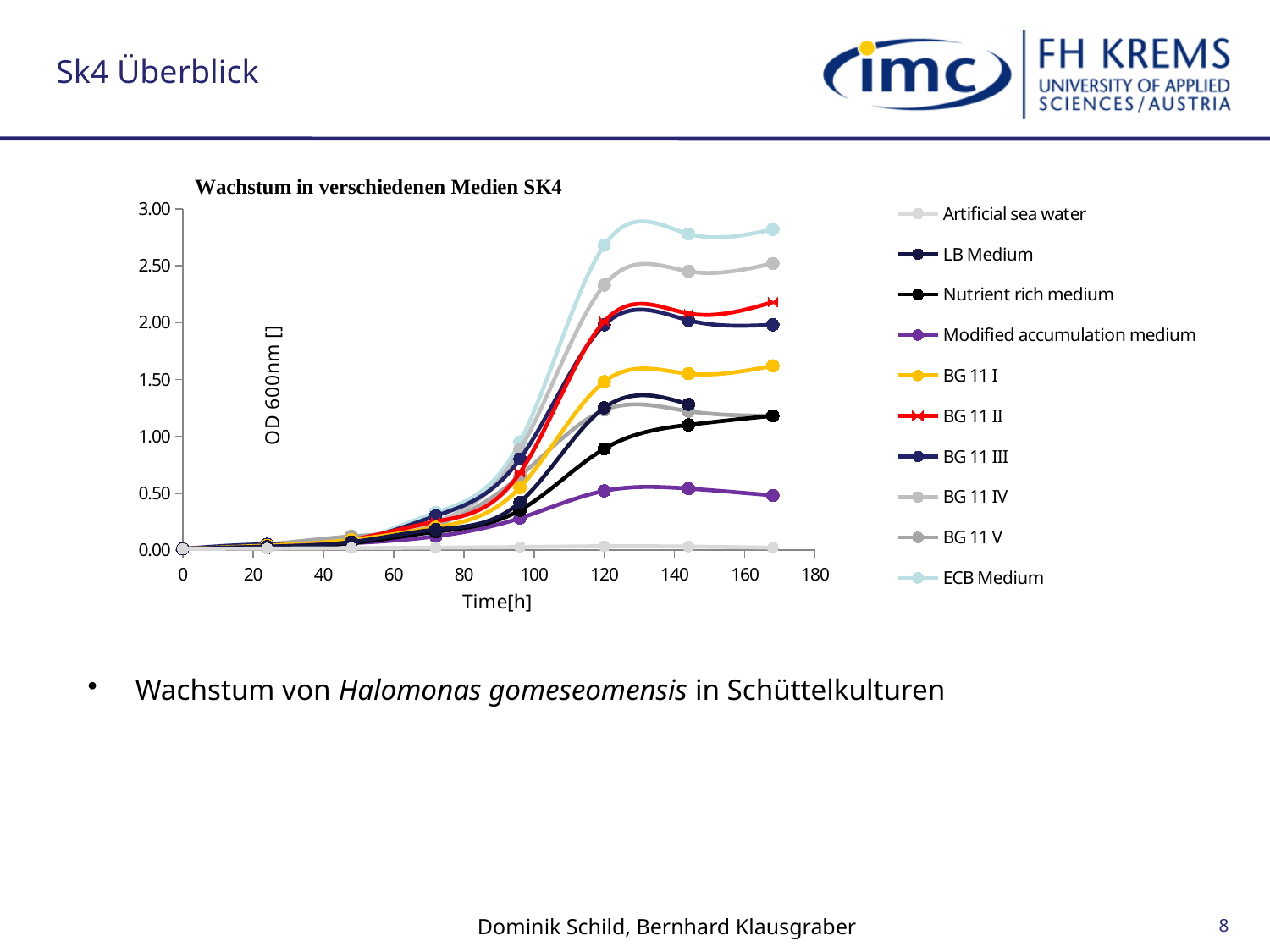
How many series does the legend list? 10 Does the OD 600nm value for ECB Medium generally rise or fall as time increases from 0 to 120 h? rise Is the value for Modified accumulation medium at the last time point greater or less than 1.00? less Which medium reaches the highest OD 600nm value at the end of the measurement (around 168 h)? ECB Medium What is the title of the chart? Wachstum in verschiedenen Medien SK4 What is the label of the x axis? Time[h] Is the value for ECB Medium at the last time point greater or less than 2.50? greater Which medium shows the lowest OD 600nm values throughout the experiment? Artificial sea water What kind of chart is shown on the slide? line chart Is the value for BG 11 IV at the last time point greater or less than 2.00? greater At the last time point, which is higher: BG 11 II or BG 11 I? BG 11 II